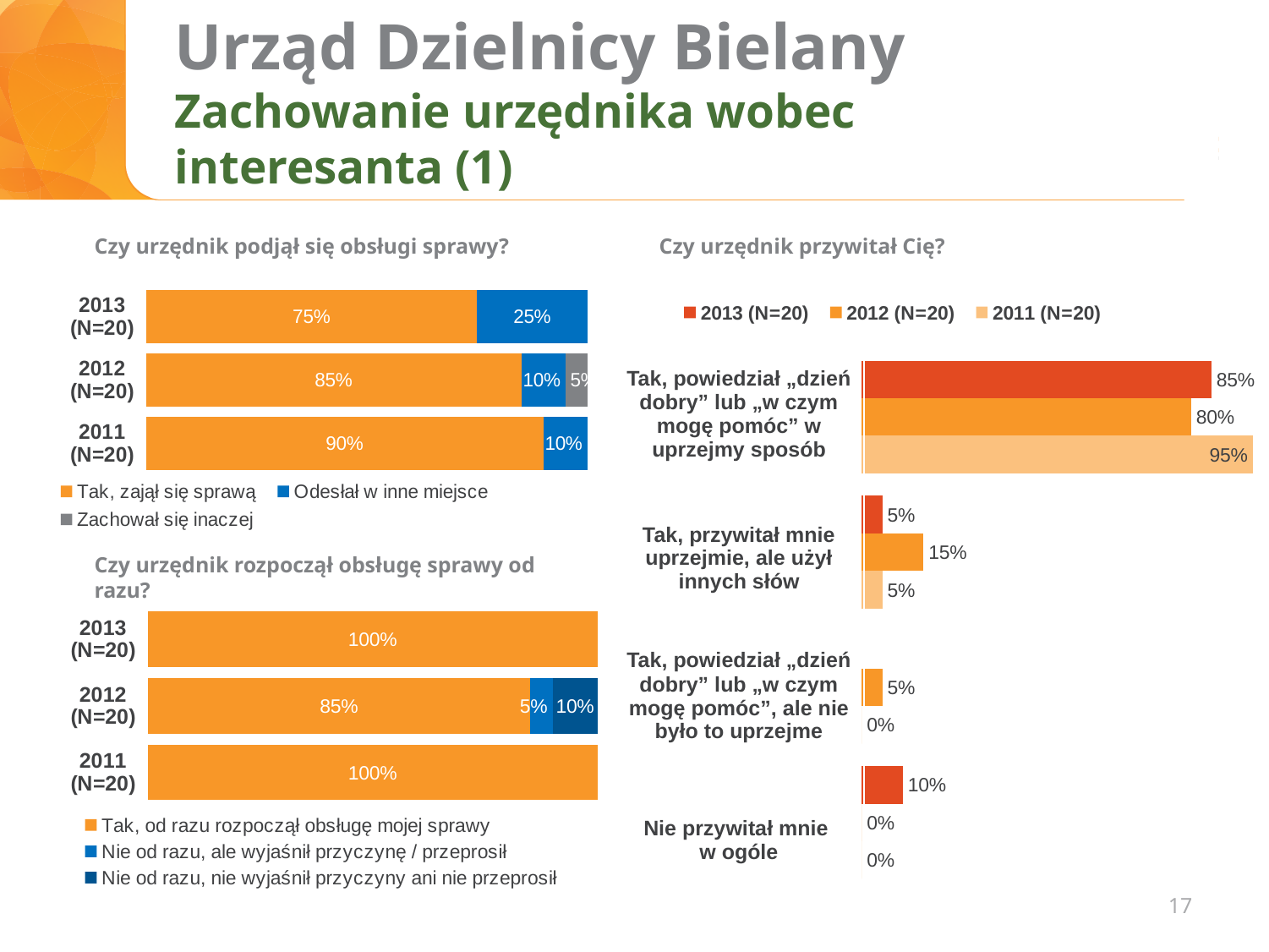
In the chart 'Czy urzędnik przywitał Cię?', what is the 2013 (N=20) value for 'Nie przywitał mnie w ogóle'? 10% In the chart 'Czy urzędnik przywitał Cię?', what is the 2011 (N=20) value for 'Tak, powiedział „dzień dobry” lub „w czym mogę pomóc” w uprzejmy sposób'? 95% In the chart 'Czy urzędnik podjął się obsługi sprawy?', what is the 'Zachował się inaczej' value for 2012 (N=20)? 5% In the chart 'Czy urzędnik podjął się obsługi sprawy?', what percentage for 2013 (N=20) is 'Tak, zajął się sprawą'? 75% In the chart 'Czy urzędnik przywitał Cię?', which year has the highest value for 'Tak, przywitał mnie uprzejmie, ale użył innych słów'? 2012 (N=20) How many series does the legend of the chart 'Czy urzędnik podjął się obsługi sprawy?' list? 3 In the chart 'Czy urzędnik podjął się obsługi sprawy?', what is the difference between the 'Odesłał w inne miejsce' values for 2013 and 2011? 15% In the chart 'Czy urzędnik rozpoczął obsługę sprawy od razu?', what is the value for 2013 (N=20)? 100% In the chart 'Czy urzędnik podjął się obsługi sprawy?', which year has the highest 'Tak, zajął się sprawą' share? 2011 (N=20) In the chart 'Czy urzędnik rozpoczął obsługę sprawy od razu?', what is the 'Nie od razu, nie wyjaśnił przyczyny ani nie przeprosił' value for 2012 (N=20)? 10% In the chart 'Czy urzędnik przywitał Cię?', how many response categories are shown? 4 What type of chart is 'Czy urzędnik rozpoczął obsługę sprawy od razu?'? Stacked bar chart